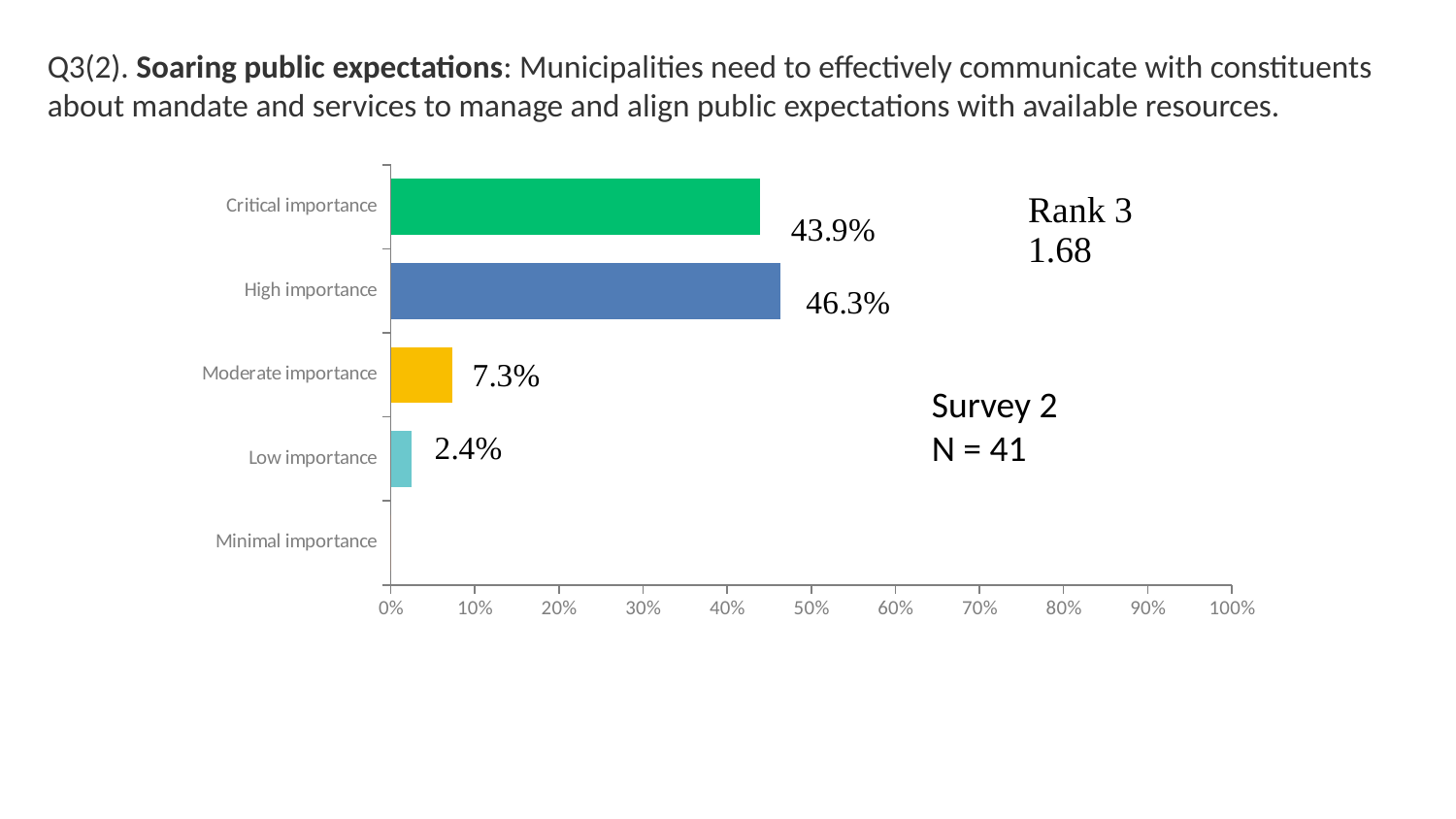
What percentage of respondents rated this as Moderate importance? 7.3% Which is larger, the value for Moderate importance or the value for Low importance? Moderate importance Which importance category has the highest percentage? High importance Which importance category has the lowest percentage? Minimal importance What is the difference in percentage points between High importance and Critical importance? 2.4% What is the N value shown for Survey 2 on the slide? N = 41 How many importance categories are shown on the chart? 5 Is the value for Critical importance greater or less than 40%? greater What percentage of respondents rated this as High importance? 46.3% What percentage of respondents rated this as Low importance? 2.4% What percentage of respondents rated this as Critical importance? 43.9% What type of chart is shown on the slide? Bar chart